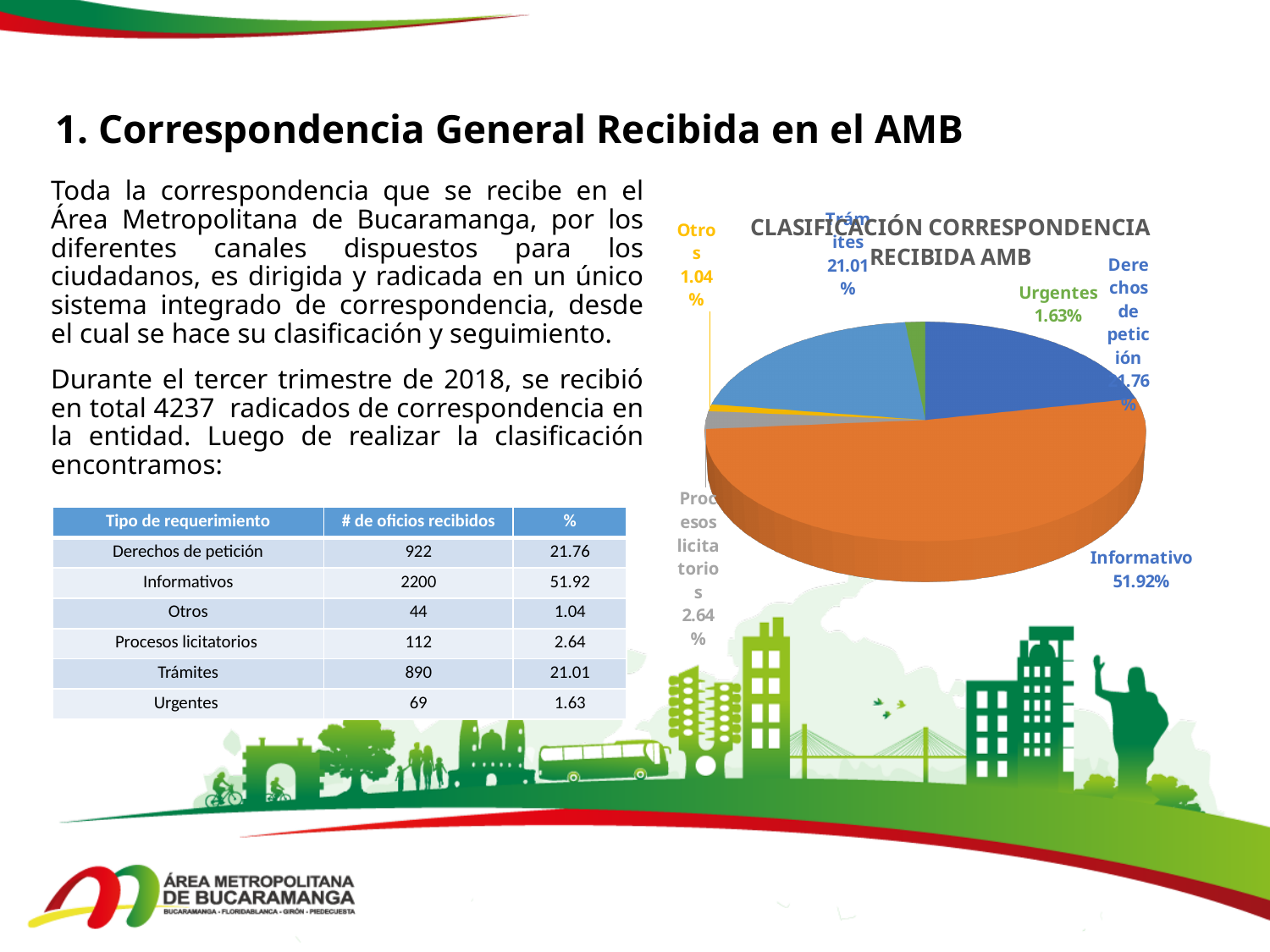
Which slice is larger in the pie chart, Trámites or Procesos licitatorios? Trámites What percentage is shown for Trámites in the pie chart? 21.01% What percentage is shown for Procesos licitatorios in the pie chart? 2.64% Which category has the largest slice in the pie chart? Informativo How many slices does the pie chart have? 6 What is the title of the pie chart? CLASIFICACIÓN CORRESPONDENCIA RECIBIDA AMB What percentage is shown for Urgentes in the pie chart? 1.63% Which category has the smallest slice in the pie chart? Otros What share of the pie chart does Informativo represent? 51.92% What kind of chart is shown on the slide? pie chart What is the difference in percentage points between the Informativo slice and the Trámites slice? 30.91 What percentage is shown for Otros in the pie chart? 1.04%